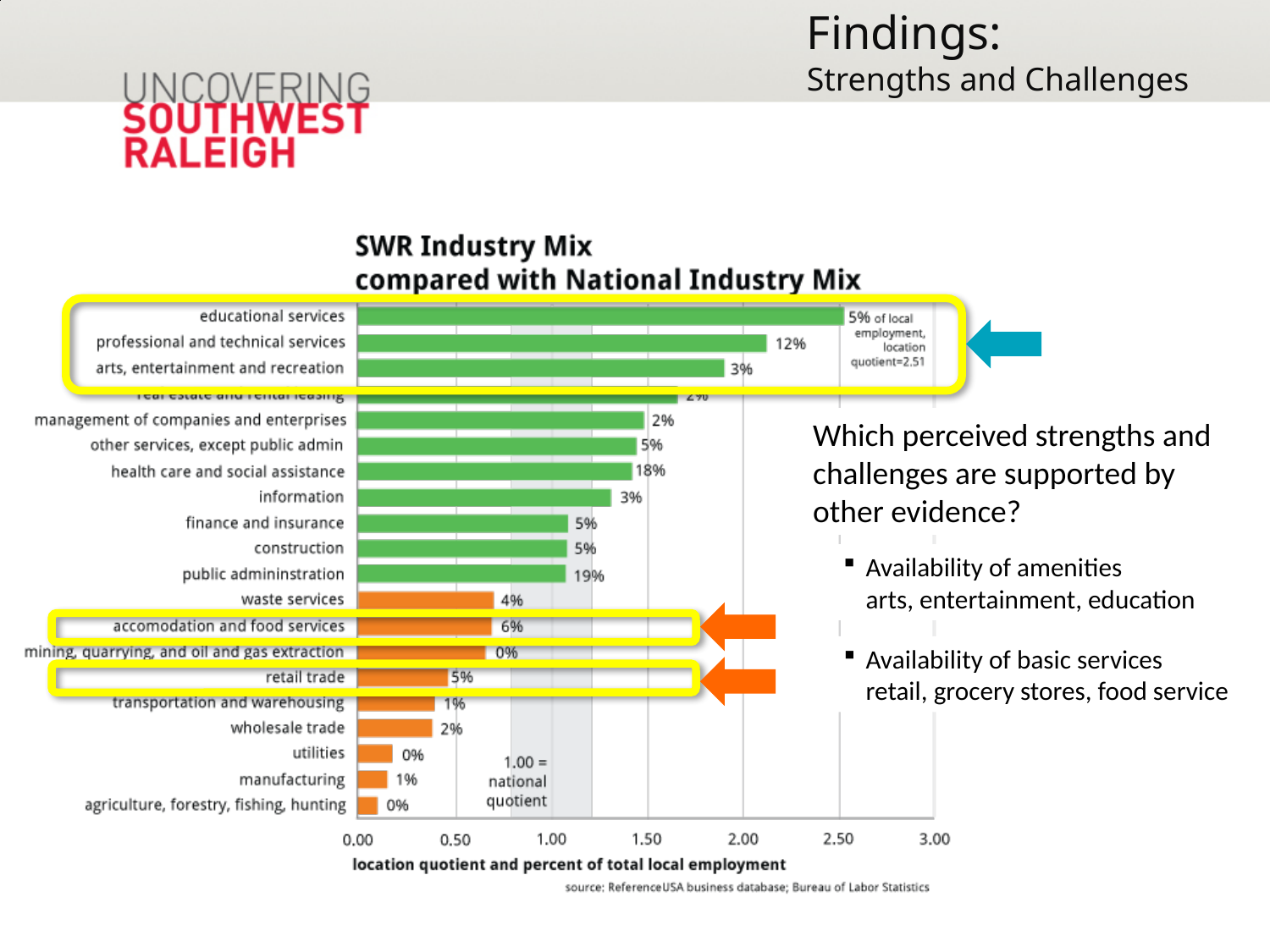
What percent of total local employment is shown for public administration? 19% Which has a larger percent of total local employment, public administration or health care and social assistance? public administration Is the location quotient for wholesale trade greater or less than 0.50? less What does the value 1.00 on the x axis represent, according to the chart annotation? national quotient What percent of total local employment is shown for health care and social assistance? 18% How many industries are listed on the chart? 20 Is the location quotient for professional and technical services greater or less than 2.00? greater What is the location quotient printed for educational services? 2.51 What kind of chart is the SWR Industry Mix chart? bar chart Which industry has the lowest location quotient (shortest bar)? agriculture, forestry, fishing, hunting What percent of total local employment is shown for professional and technical services? 12% Which industry has the highest location quotient (longest bar)? educational services